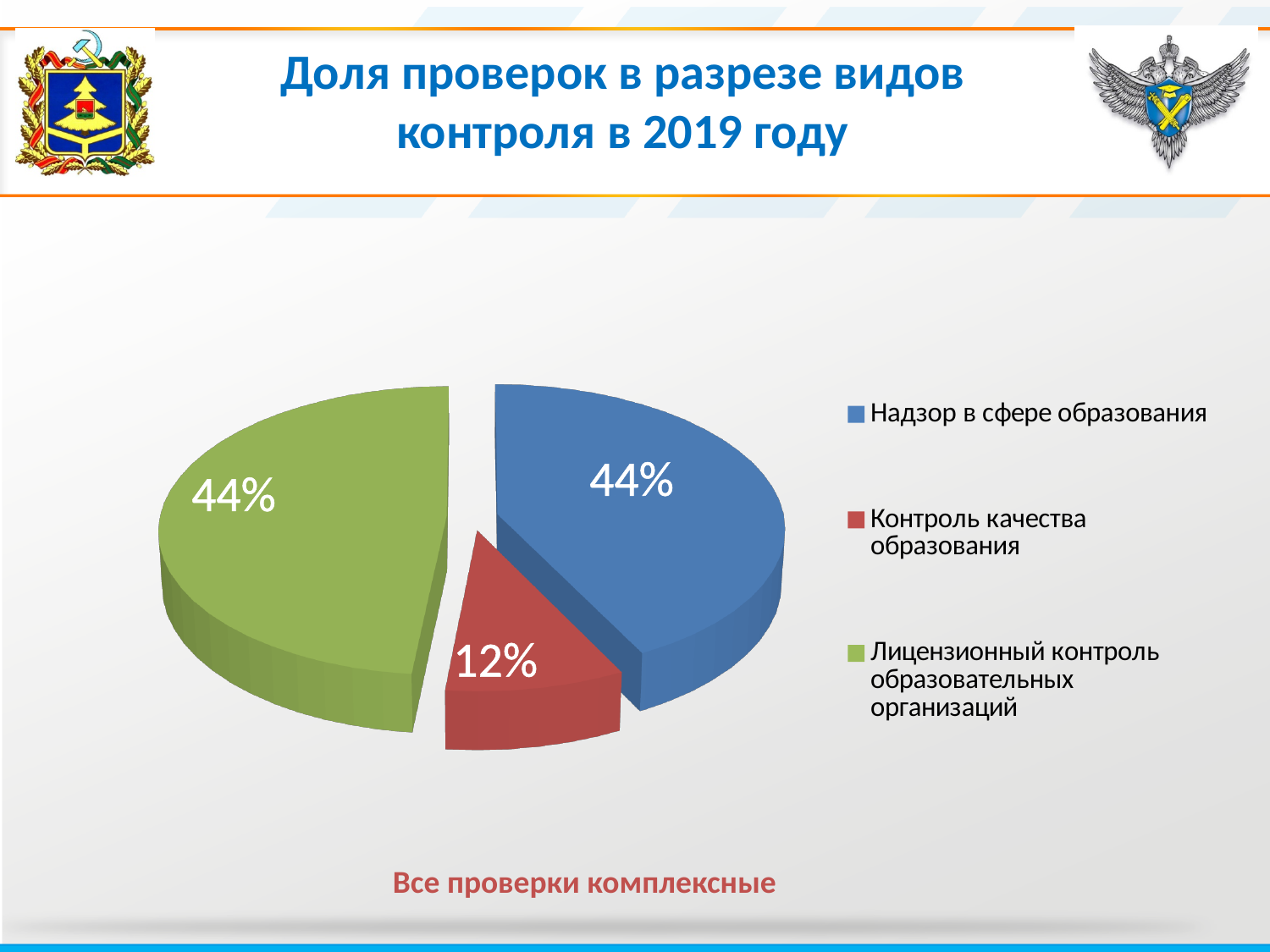
What is the title of the chart on the slide? Доля проверок в разрезе видов контроля в 2019 году Which has a larger share: "Надзор в сфере образования" or "Контроль качества образования"? Надзор в сфере образования How many entries does the legend list? 3 What share of inspections is shown for "Лицензионный контроль образовательных организаций"? 44% Which type of control has the smallest share of inspections? Контроль качества образования What type of chart is shown on the slide? Pie chart What is the difference in percentage points between the share for "Лицензионный контроль образовательных организаций" and the share for "Контроль качества образования"? 32 percentage points Which colour represents "Контроль качества образования" in the pie chart? Red What share of inspections is shown for "Контроль качества образования"? 12% Do the shares for "Надзор в сфере образования" and "Лицензионный контроль образовательных организаций" have the same value? Yes, both 44% What share of inspections is shown for "Надзор в сфере образования"? 44% How many slices does the pie chart have? 3